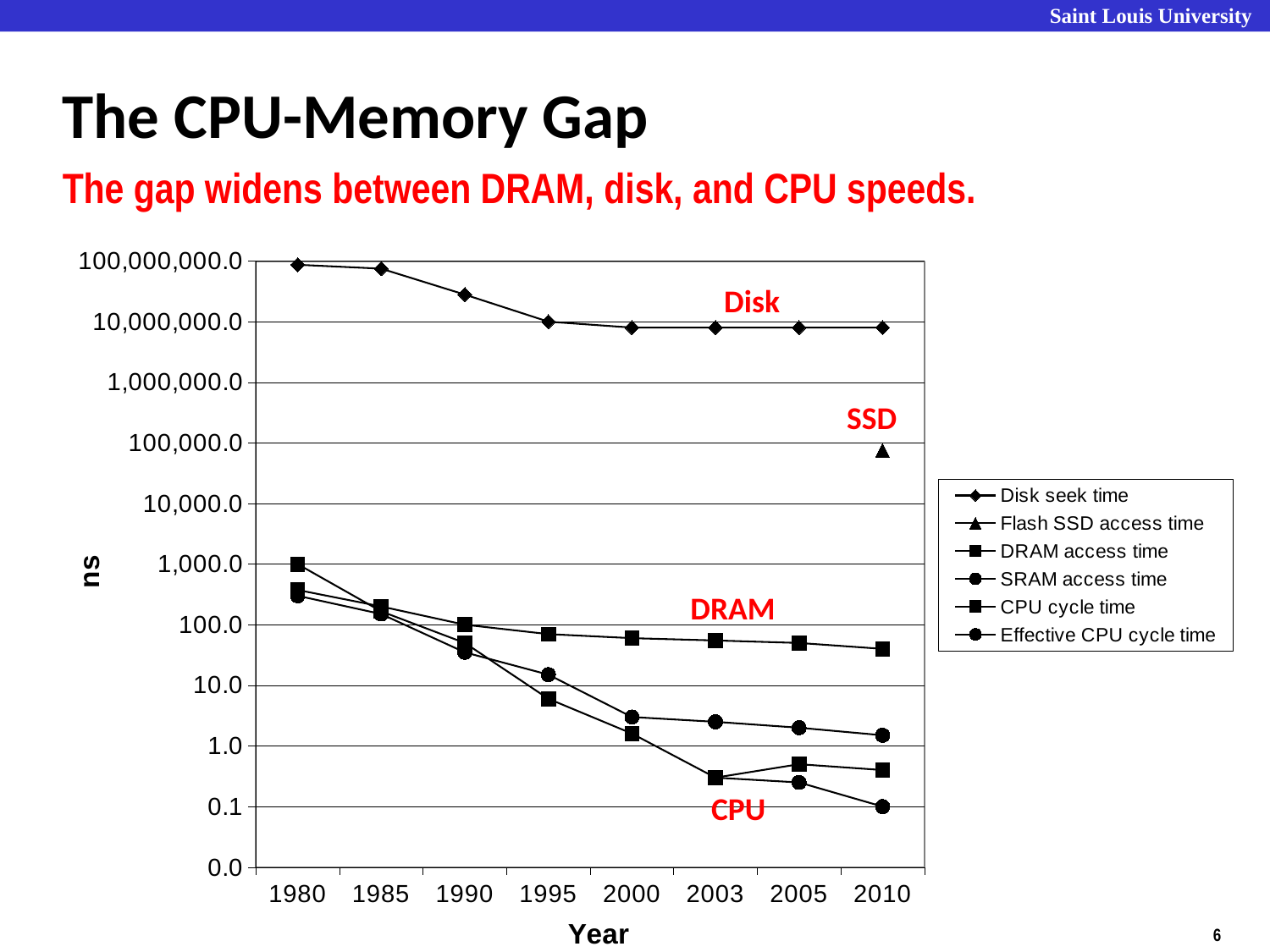
Which series has the highest value in 2010? Disk seek time How many years are shown on the x axis? 8 What is the label of the x axis? Year Does the Disk seek time rise or fall from 1980 to 2010? fall What is the Disk seek time in 1995? 10,000,000.0 How many series does the legend list? 6 Is the DRAM access time in 2010 greater or less than 100.0 ns? less Is the Disk seek time in 2010 greater or less than 1,000,000.0 ns? greater Is the Flash SSD access time in 2010 greater or less than 100,000.0 ns? less What kind of chart is shown on the slide? line chart Which series has the lowest value in 2010? Effective CPU cycle time In 2000, which is larger: Disk seek time or DRAM access time? Disk seek time